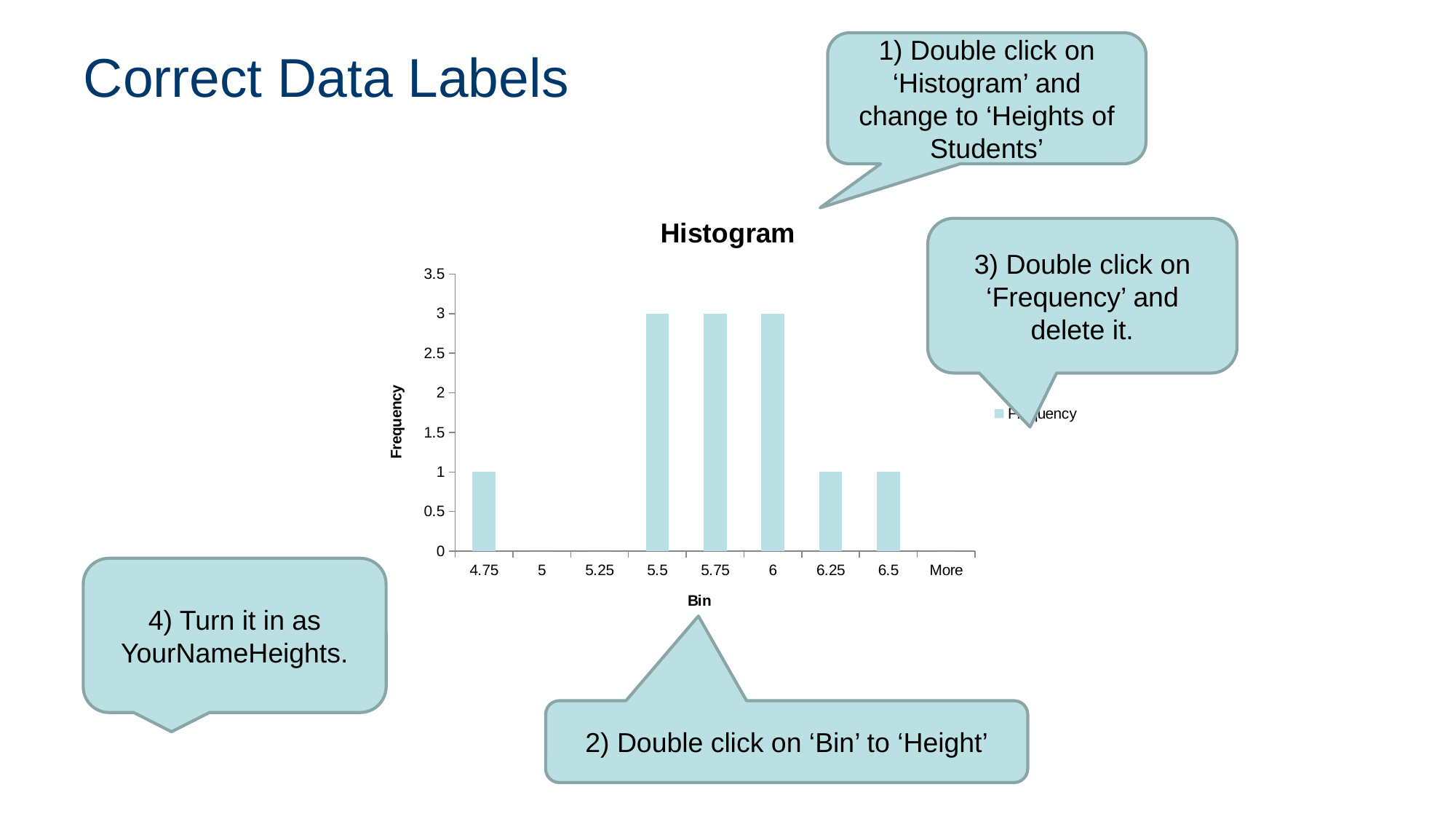
How many bins are labelled on the x axis? 9 What kind of chart is shown on the slide? bar chart What is the frequency for the 4.75 bin? 1 What is the frequency for the 5.5 bin? 3 What is the difference between the frequency for 5.75 and the frequency for 6.5? 2 How many bins have a frequency of 3? 3 What is the frequency for the 5 bin? 0 What is the frequency for the 6.25 bin? 1 What is the title of the chart? Histogram Which is larger, the frequency for 6 or the frequency for 6.5? 6 What is the label of the x axis? Bin Is the frequency for the 6 bin greater or less than 2? greater